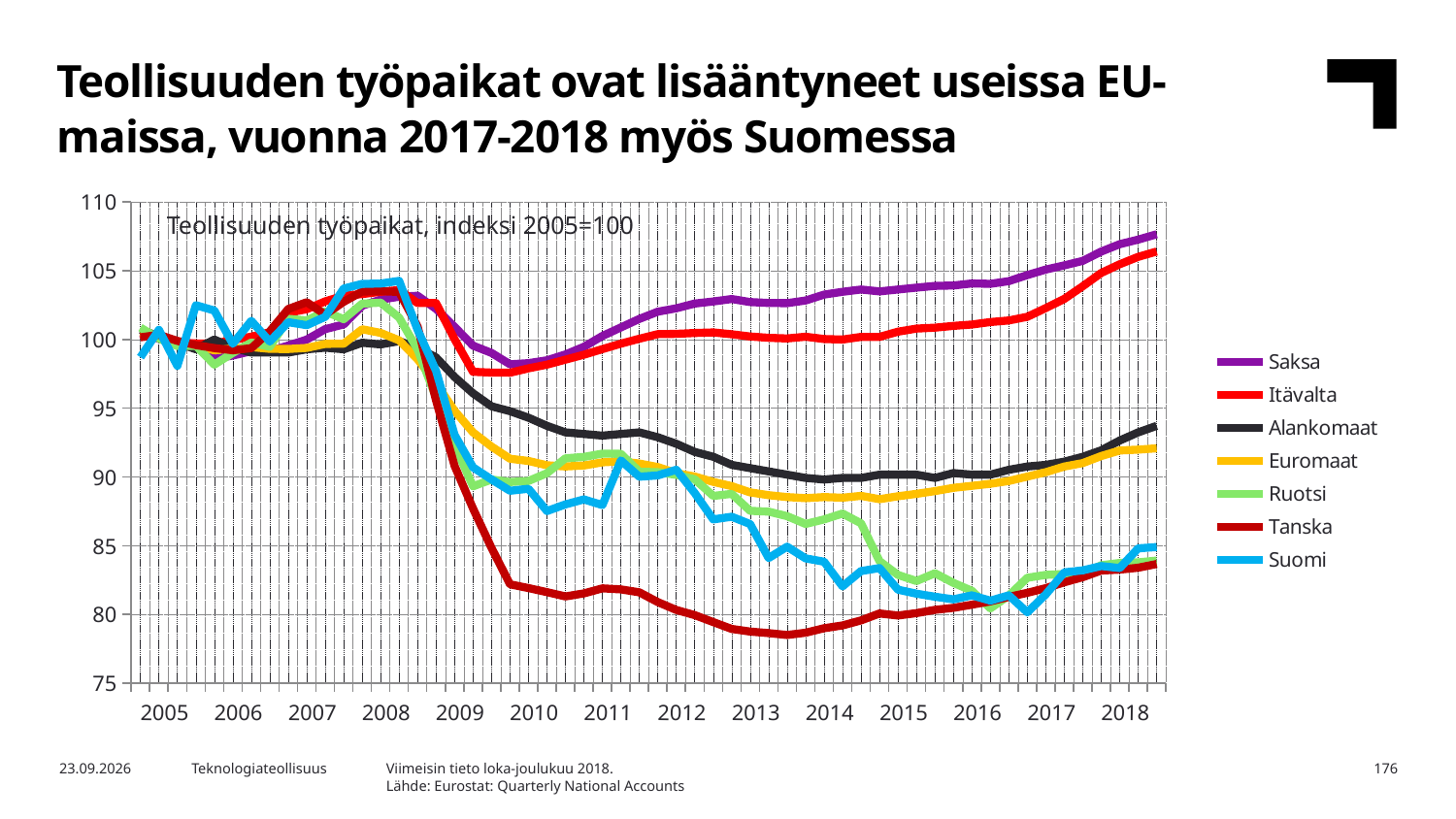
How many series does the legend list? 7 How many years are labelled on the x axis? 14 Does the Tanska series rise or fall between 2008 and 2010? fall Is the value for Alankomaat in 2016 greater or less than 95? less Is the value for Tanska in 2014 greater or less than 80? less What kind of chart is shown on the slide? line chart In 2015, which is larger: the value for Euromaat or the value for Ruotsi? Euromaat Which colour is used for the Suomi series in the legend? light blue Is the value for Saksa in 2018 greater or less than 105? greater What is the title printed inside the chart area? Teollisuuden työpaikat, indeksi 2005=100 Which series has the highest value at the end of 2018? Saksa Which series has the lowest value during 2014? Tanska